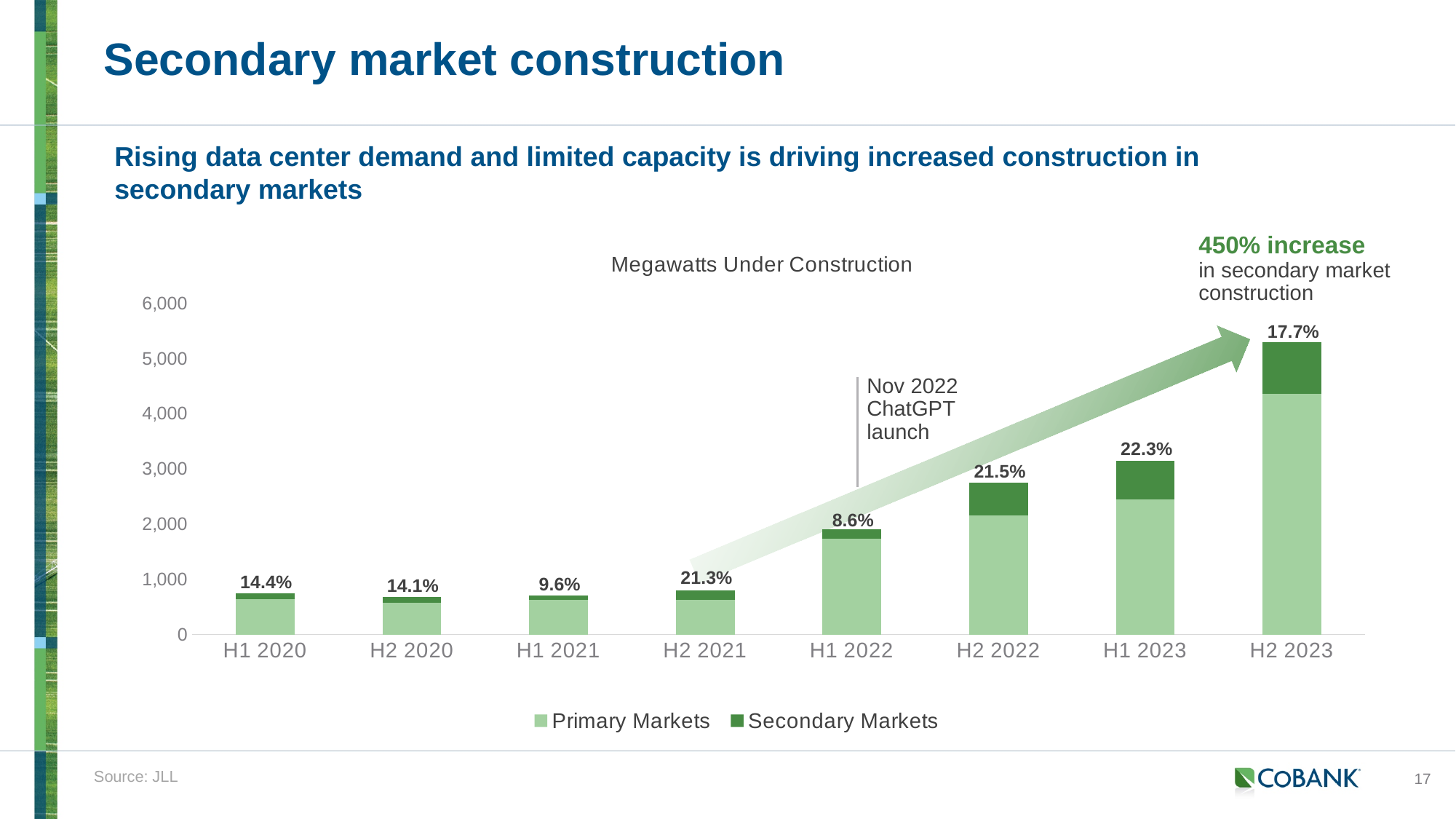
What type of chart is shown on the slide? Stacked bar chart Is the total megawatts under construction for H2 2023 greater or less than 5,000? greater What is the title of the chart? Megawatts Under Construction How many periods are shown on the x axis of the chart? 8 What percentage label is shown above the H2 2023 bar? 17.7% Which period has the lowest percentage label? H1 2022 How many series does the legend list? 2 Which period has the highest percentage label? H1 2023 What is the difference between the percentage labels for H1 2023 and H1 2022? 13.7 percentage points What percentage label is shown above the H2 2021 bar? 21.3% Is the total megawatts under construction for H1 2020 greater or less than 1,000? less Which has the larger percentage label, H1 2021 or H2 2021? H2 2021